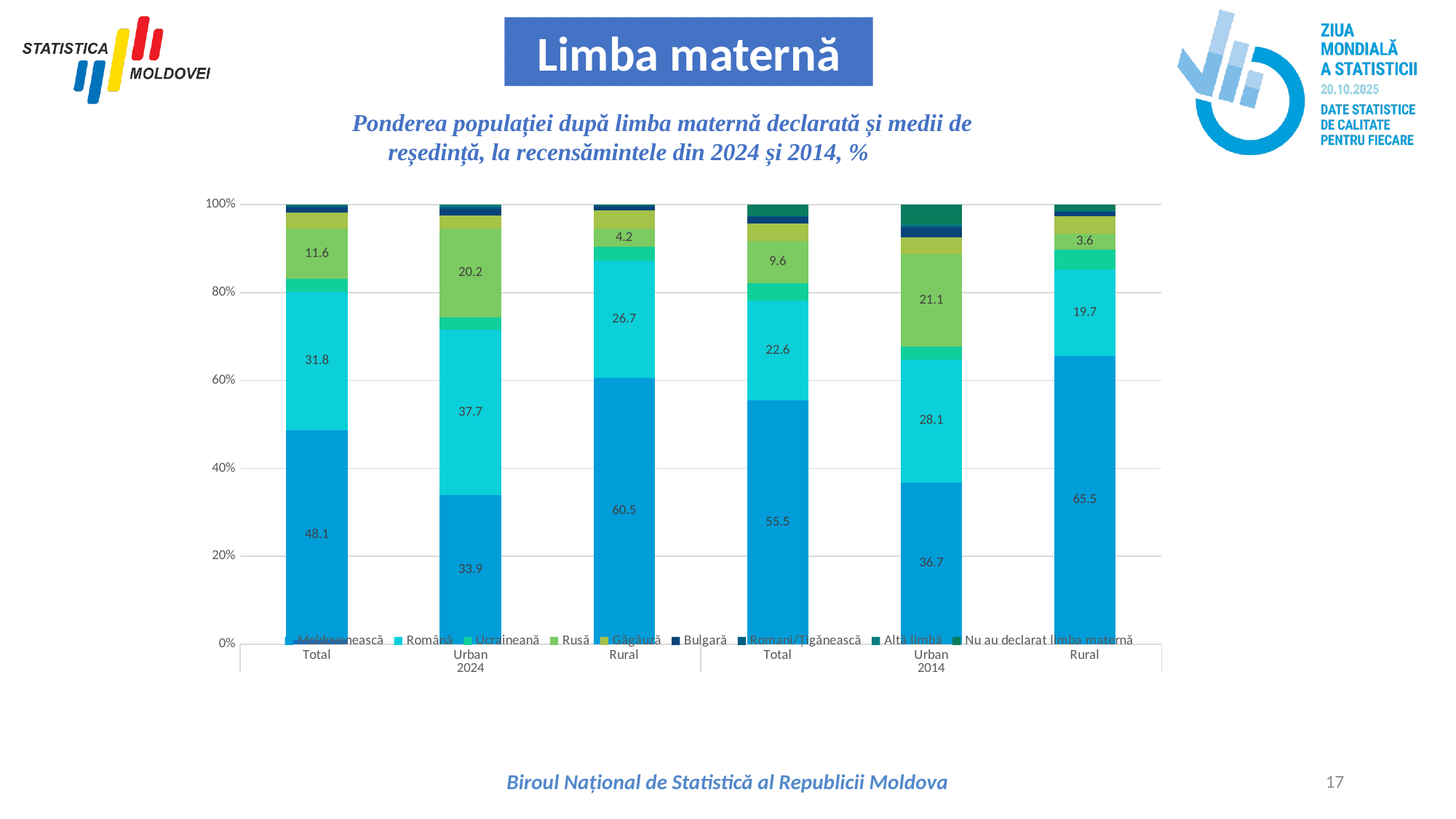
What is the share of Rusă for Urban in 2014? 21.1 What is the difference between the Moldovenească share for Rural 2024 and Urban 2024? 26.6 Which is larger: the Română share for Total 2024 or for Total 2014? Total 2024 Which category has the highest Moldovenească share? Rural 2014 What is the share of Română for Urban in 2024? 37.7 What is the share of Moldovenească for Rural in 2024? 60.5 What is the share of Moldovenească for Total in 2014? 55.5 What kind of chart is shown on the slide? stacked bar chart Which category has the lowest Rusă share? Rural 2014 How many series does the legend list? 9 How many bars (categories) are plotted on the chart? 6 Is the Moldovenească share for Urban 2014 greater or less than 40%? less